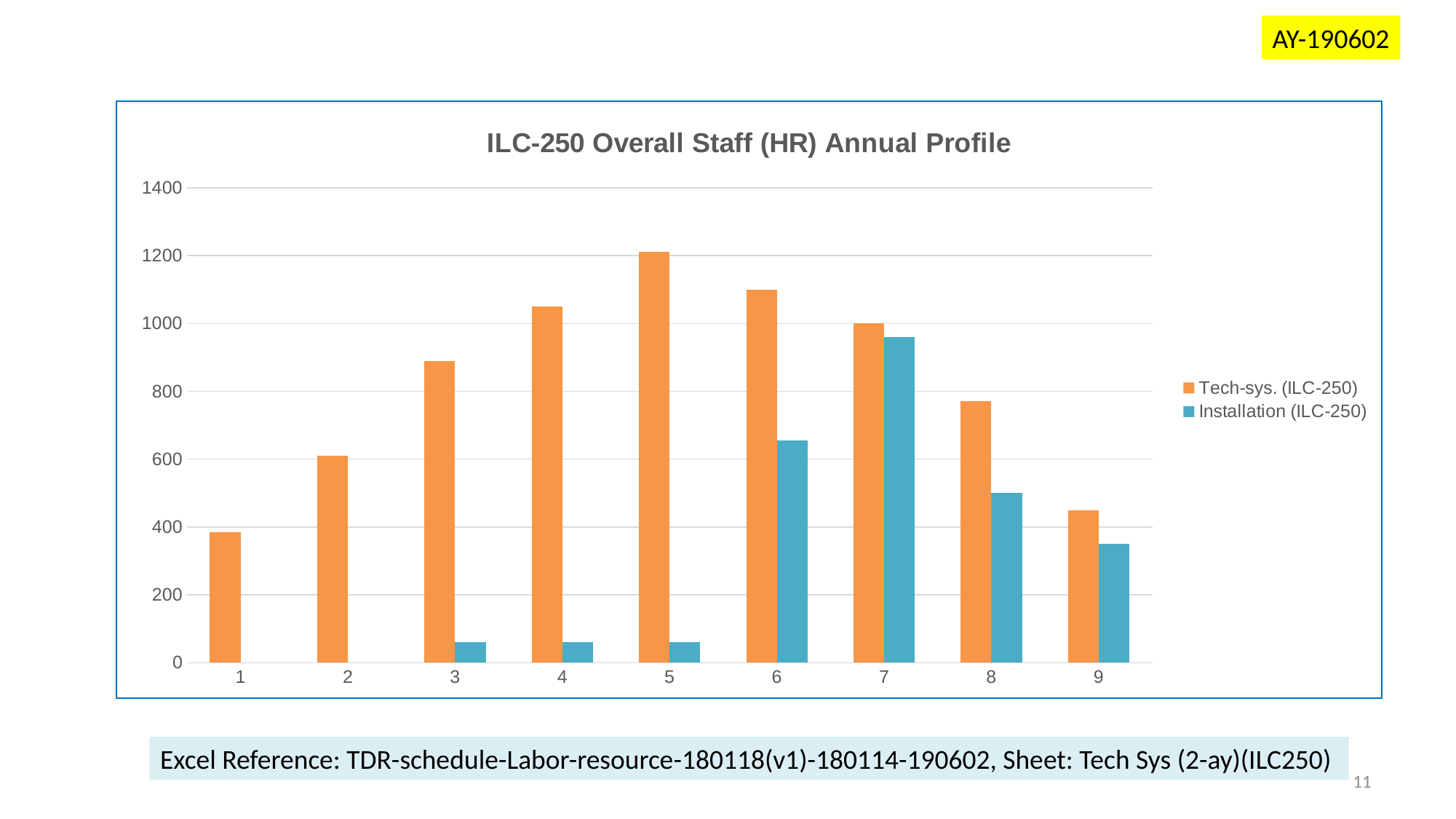
Do the Tech-sys. (ILC-250) values rise or fall from category 5 to category 9? fall Which is larger for category 8, the Tech-sys. (ILC-250) value or the Installation (ILC-250) value? Tech-sys. (ILC-250) Is the Installation (ILC-250) value for category 6 greater or less than 600? greater Is the Tech-sys. (ILC-250) value for category 1 greater or less than 400? less What is the title of the chart? ILC-250 Overall Staff (HR) Annual Profile Which category has the highest Installation (ILC-250) value? 7 What type of chart is shown on the slide? bar chart How many series does the legend list? 2 How many categories are shown on the x axis? 9 Which category has the highest Tech-sys. (ILC-250) value? 5 Which category has the lowest Tech-sys. (ILC-250) value? 1